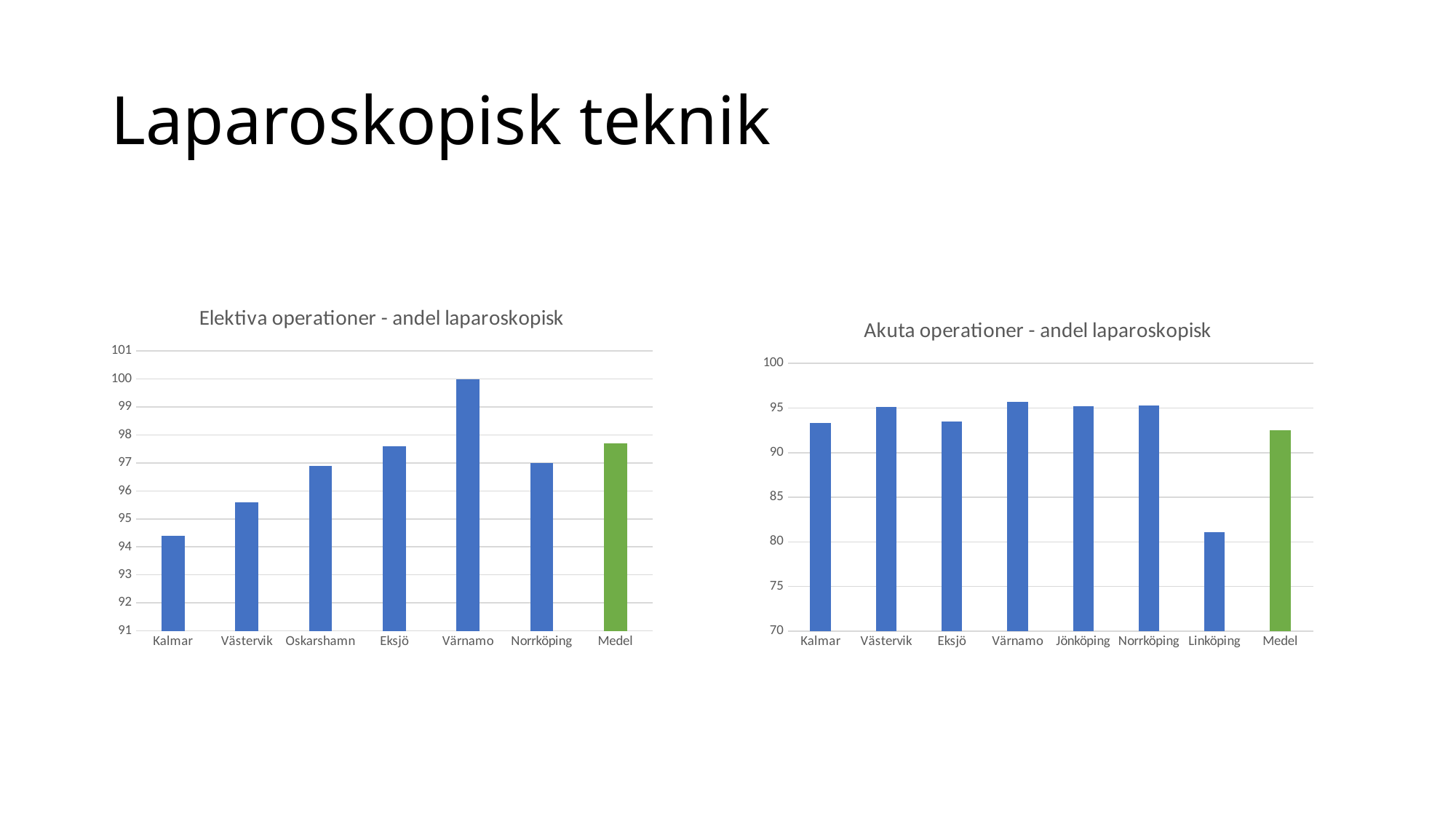
How many categories are shown on the x axis of the 'Akuta operationer - andel laparoskopisk' chart? 8 In the 'Akuta operationer - andel laparoskopisk' chart, is the value for Medel greater or less than 90? greater In the 'Elektiva operationer - andel laparoskopisk' chart, is the value for Kalmar greater or less than 95? less In the 'Elektiva operationer - andel laparoskopisk' chart, which is larger, the value for Eksjö or the value for Västervik? Eksjö In the 'Akuta operationer - andel laparoskopisk' chart, which category has the lowest value? Linköping In the 'Elektiva operationer - andel laparoskopisk' chart, which category has the highest value? Värnamo In the 'Akuta operationer - andel laparoskopisk' chart, is the value for Linköping greater or less than 85? less How many categories are shown on the x axis of the 'Elektiva operationer - andel laparoskopisk' chart? 7 In the 'Elektiva operationer - andel laparoskopisk' chart, which category has the lowest value? Kalmar What kind of chart is the 'Elektiva operationer - andel laparoskopisk' chart? bar chart In the 'Akuta operationer - andel laparoskopisk' chart, what colour is the Medel bar? green In the 'Elektiva operationer - andel laparoskopisk' chart, what value does the Värnamo bar reach? 100